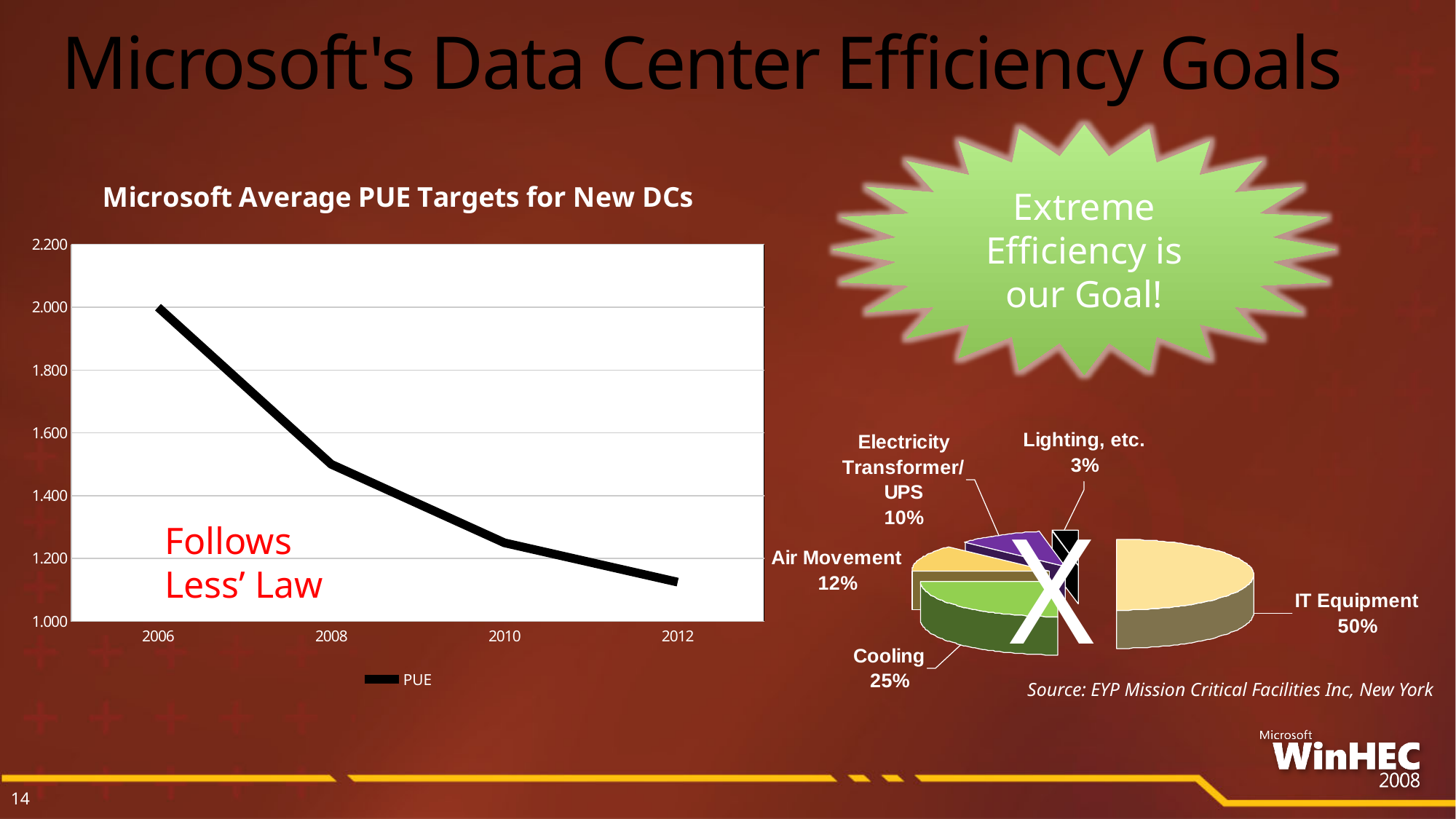
In the chart titled 'Microsoft Average PUE Targets for New DCs', how many years are plotted on the x axis? 4 In the chart titled 'Microsoft Average PUE Targets for New DCs', which year has the highest PUE value? 2006 In the pie chart on the right of the slide, how many slices are there? 5 In the pie chart on the right of the slide, what is the difference between the Cooling share and the Air Movement share? 13% In the chart titled 'Microsoft Average PUE Targets for New DCs', is the PUE value for 2012 greater or less than 1.200? less In the chart titled 'Microsoft Average PUE Targets for New DCs', do the PUE values rise or fall from 2006 to 2012? fall In the chart titled 'Microsoft Average PUE Targets for New DCs', what kind of chart is shown? line chart In the pie chart on the right of the slide, what share does IT Equipment have? 50% In the chart titled 'Microsoft Average PUE Targets for New DCs', is the PUE value for 2008 greater or less than 1.600? less In the chart titled 'Microsoft Average PUE Targets for New DCs', how many series does the legend list? 1 In the pie chart on the right of the slide, which category has the smallest share? Lighting, etc. In the chart titled 'Microsoft Average PUE Targets for New DCs', is the PUE value for 2006 greater or less than 1.800? greater